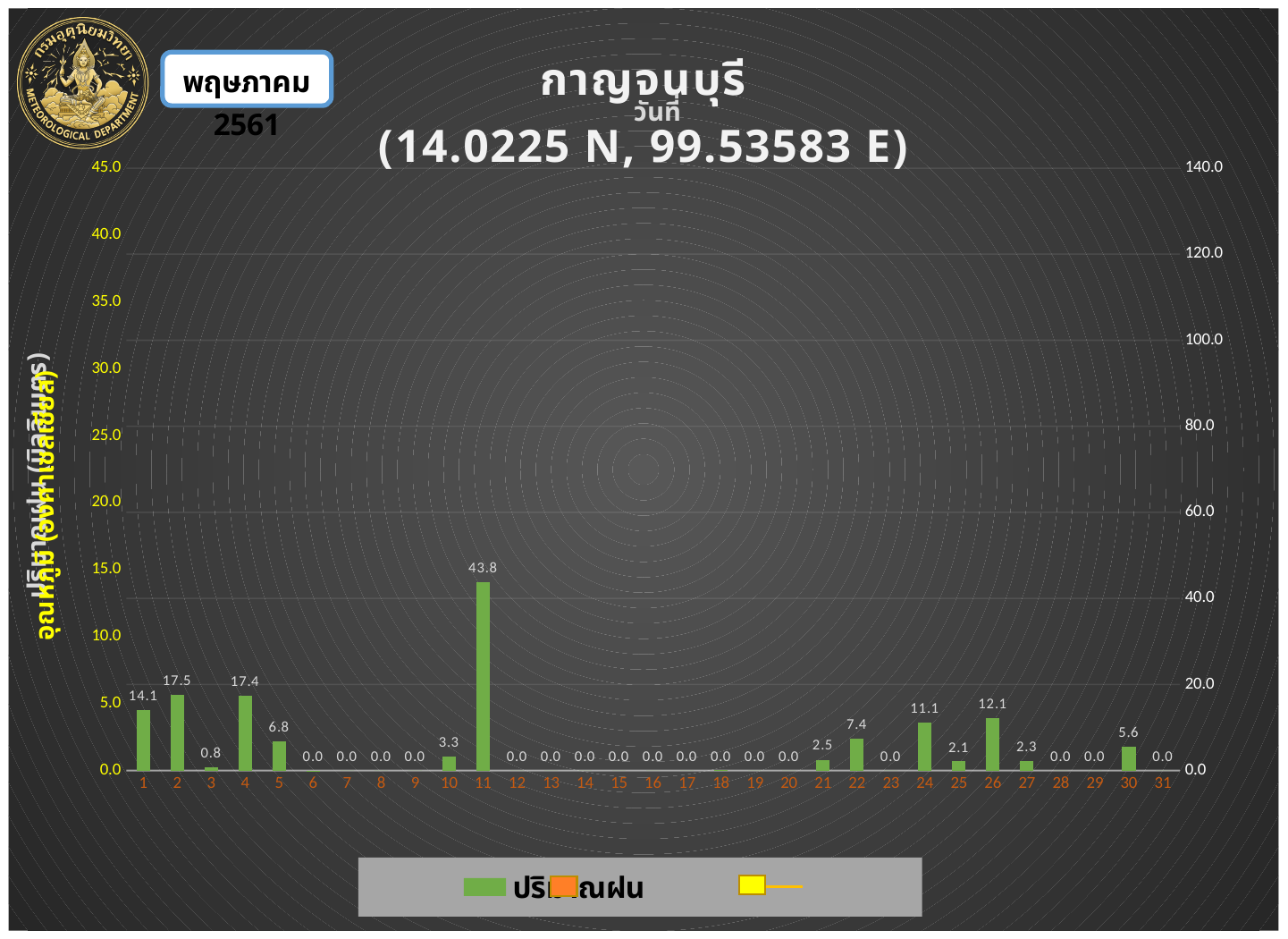
What is the rainfall value shown for day 30? 5.6 What is the rainfall value shown for day 11? 43.8 How many days are shown on the x axis? 31 What is the difference between the rainfall values for day 11 and day 1? 29.7 Which day has the highest rainfall value? 11 Which is larger, the rainfall value for day 5 or for day 10? day 5 Which is larger, the rainfall value for day 26 or for day 22? day 26 What is the rainfall value shown for day 24? 11.1 What is the rainfall value shown for day 2? 17.5 What is the difference between the rainfall values for day 2 and day 4? 0.1 What colour are the rainfall bars in the chart? green What kind of chart is shown on the slide? bar chart